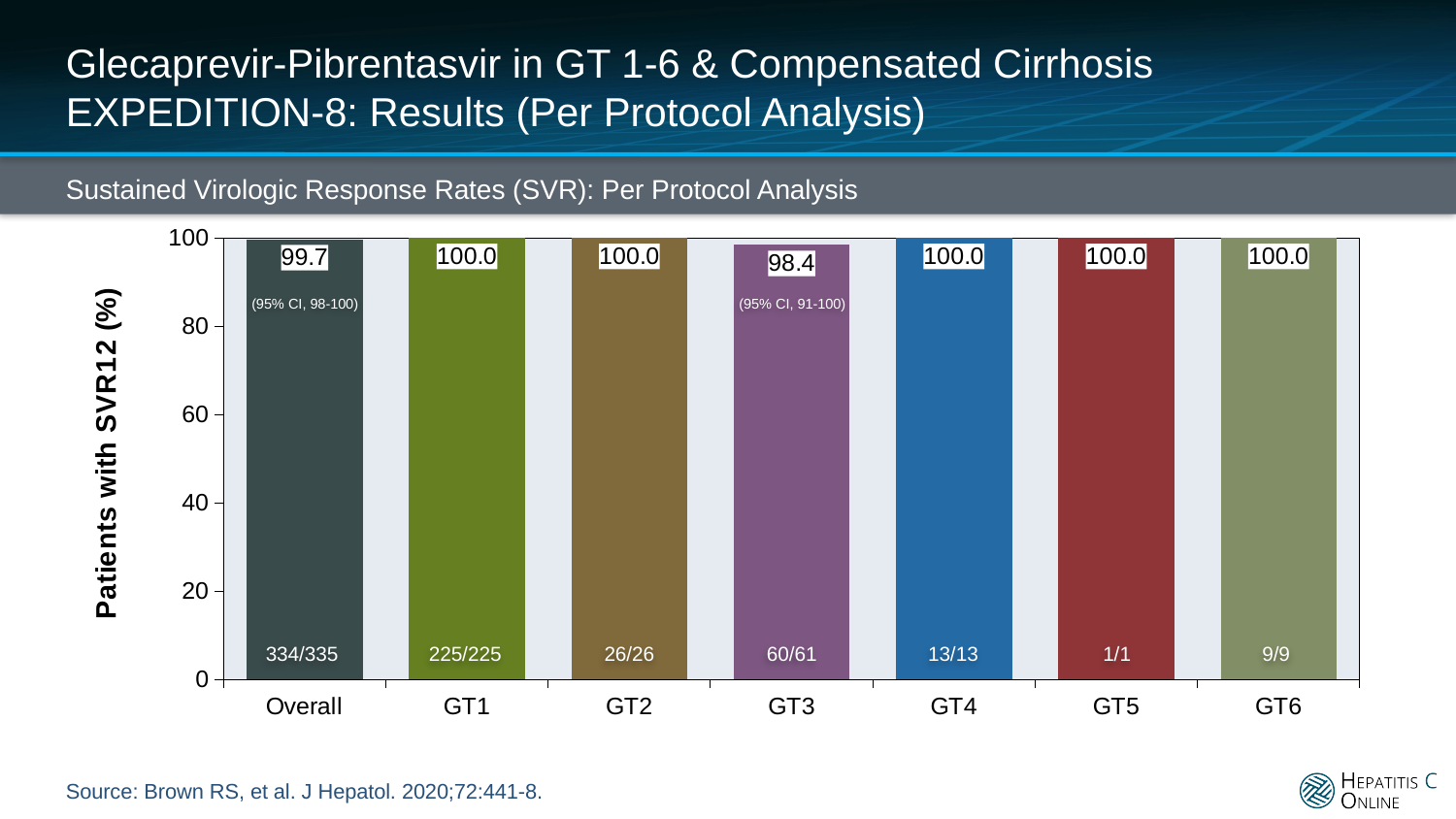
What is the SVR12 rate for the Overall group? 99.7 What fraction of patients achieved SVR12 in GT3? 60/61 What is the 95% confidence interval shown for GT3? 91-100 Which genotype group has the lowest SVR12 rate? GT3 What fraction of patients achieved SVR12 in the Overall group? 334/335 What is the y-axis label of the chart? Patients with SVR12 (%) What is the SVR12 rate for GT1? 100.0 What is the SVR12 rate for GT3? 98.4 What kind of chart is shown? Bar chart What is the difference in SVR12 rate between GT1 and GT3? 1.6 Which is larger, the SVR12 rate for Overall or for GT3? Overall How many categories are shown on the x axis? 7